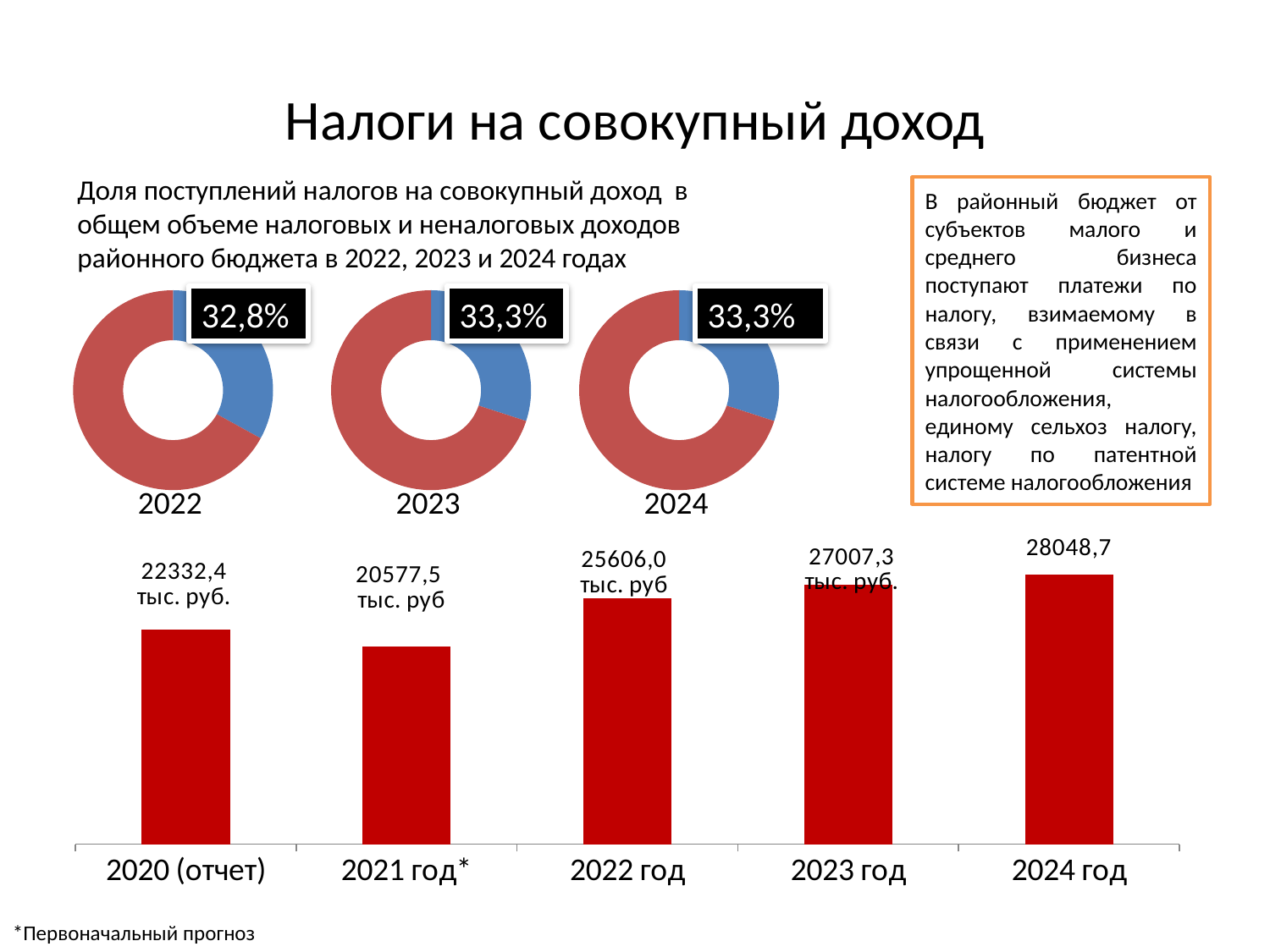
In the bar chart at the bottom of the slide, what is the value for 2024 год? 28048,7 What kind of chart is shown at the bottom of the slide? bar chart In the bar chart at the bottom of the slide, which category has the highest value? 2024 год In the donut chart labelled 2022, what share is shown by the data label? 32,8% In the bar chart at the bottom of the slide, do the values rise or fall from 2021 год* to 2024 год? rise In the bar chart at the bottom of the slide, which category has the lowest value? 2021 год* In the bar chart at the bottom of the slide, what is the value for 2022 год? 25606,0 тыс. руб In the bar chart at the bottom of the slide, which is larger: the value for 2020 (отчет) or the value for 2021 год*? 2020 (отчет) How many categories are shown in the bar chart at the bottom of the slide? 5 In the bar chart at the bottom of the slide, what is the difference between the values for 2024 год and 2023 год? 1041,4 In the donut chart labelled 2024, what share is shown by the data label? 33,3% In the bar chart at the bottom of the slide, what is the value for 2020 (отчет)? 22332,4 тыс. руб.